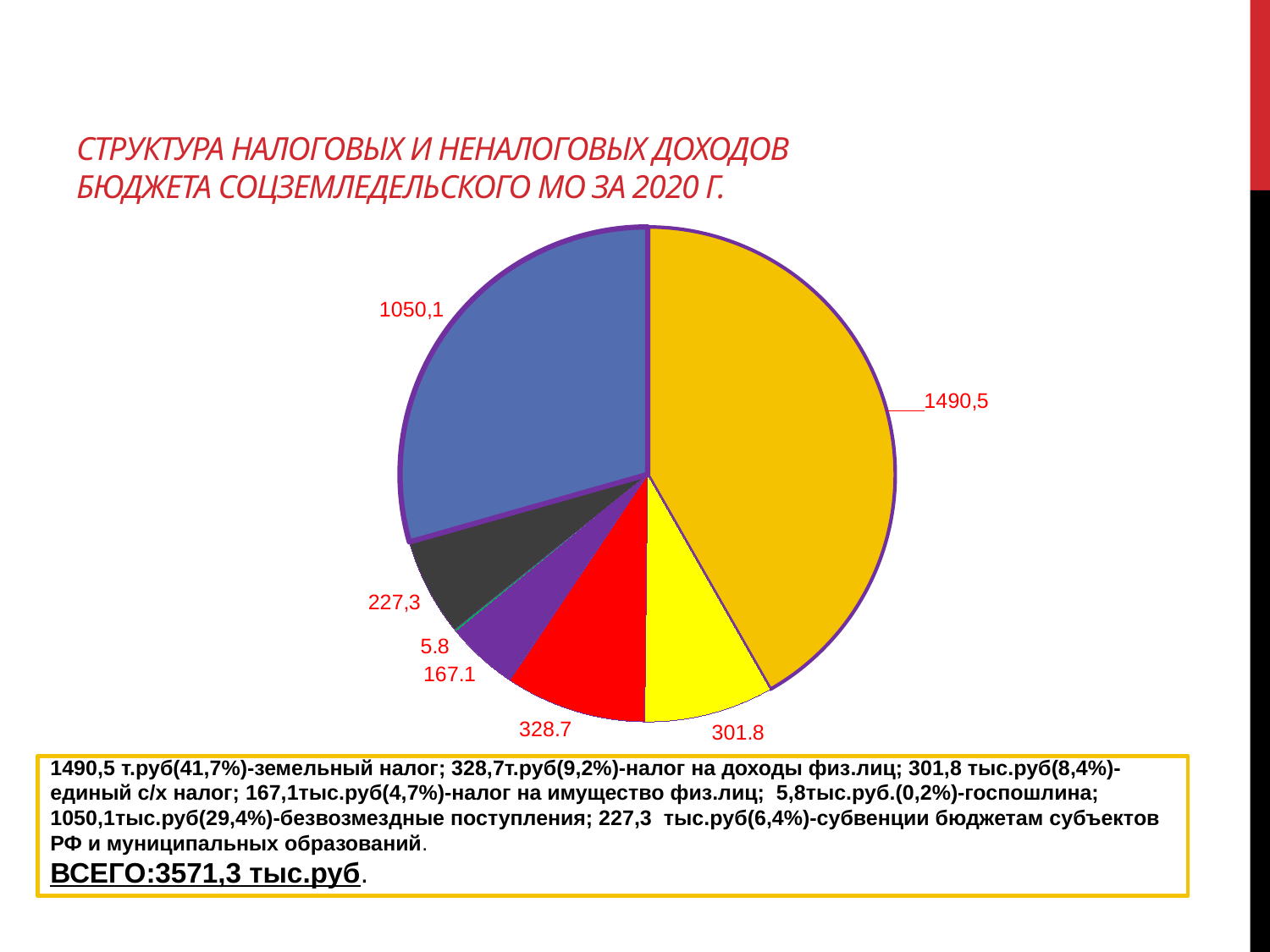
According to the slide, what share of the total does земельный налог (1490,5) represent? 41,7% What is the value of the largest slice of the pie chart? 1490,5 What is the value of the smallest slice of the pie chart? 5.8 What value is shown for the red slice of the pie chart? 328.7 What value is shown for the blue slice of the pie chart? 1050,1 What is the total (ВСЕГО) of all the values in the pie chart, as stated on the slide? 3571,3 тыс.руб What value is shown for the dark grey slice of the pie chart? 227,3 What value is shown for the yellow slice of the pie chart? 301.8 What kind of chart is shown on the slide? pie chart How many slices does the pie chart have? 7 What is the difference between the slice labelled 1490,5 and the slice labelled 1050,1? 440,4 Which is larger: the slice labelled 328.7 or the slice labelled 301.8? 328.7